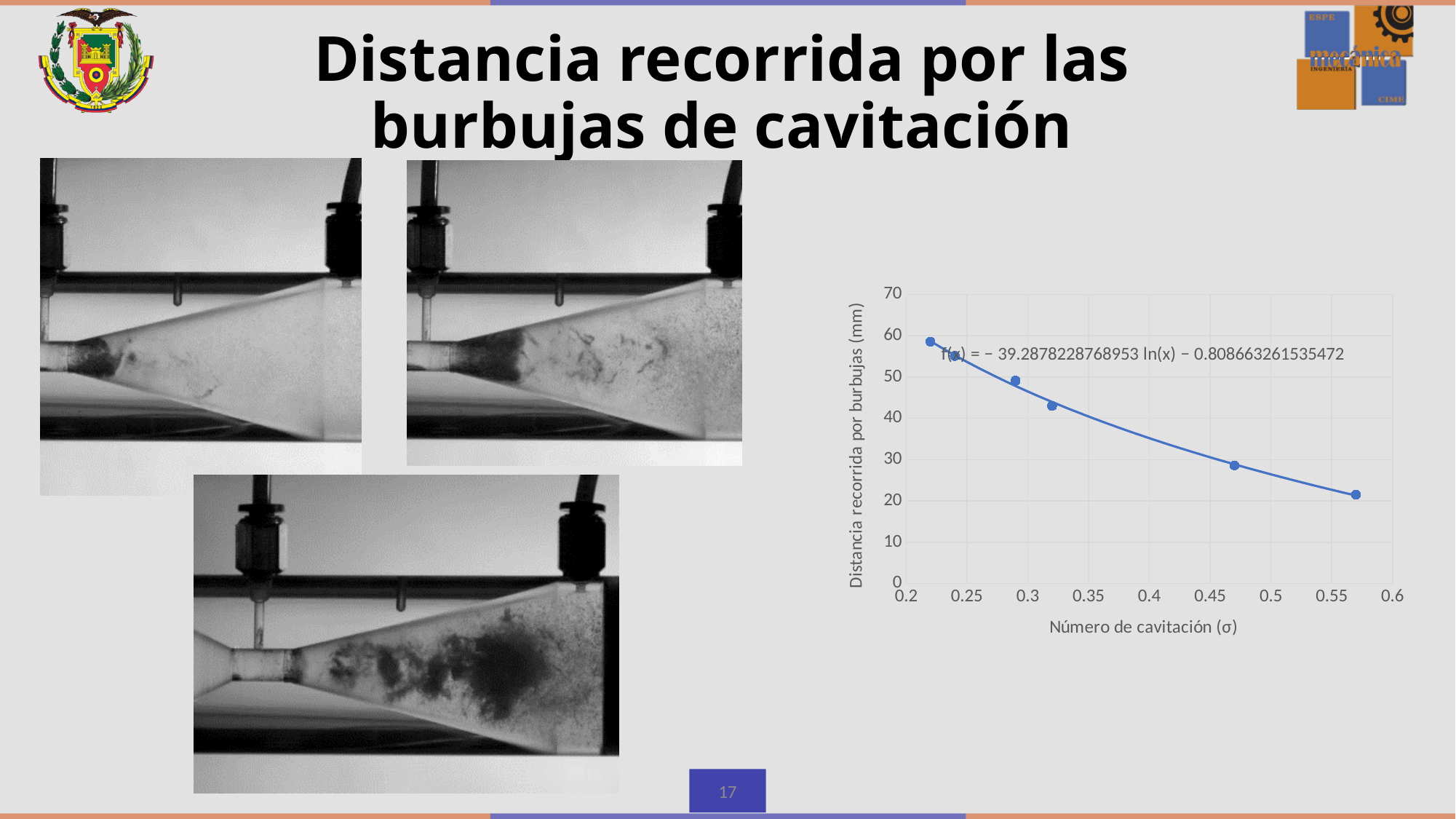
What is the title of the y axis of the chart? Distancia recorrida por burbujas (mm) What is the maximum value shown on the y axis of the chart? 70 What is the title of the x axis of the chart? Número de cavitación (σ) How many data points are plotted in the chart? 6 Is the distance for the data point near a cavitation number of 0.32 greater or less than 50 mm? less As the cavitation number increases along the x axis, does the distance travelled by the bubbles rise or fall? fall Is the distance for the data point near a cavitation number of 0.47 greater or less than 20 mm? greater Which data point has the larger distance: the one near a cavitation number of 0.29 or the one near 0.57? the one near 0.29 Is the distance for the data point at the largest cavitation number greater or less than 30 mm? less What kind of chart is shown on the slide? scatter chart